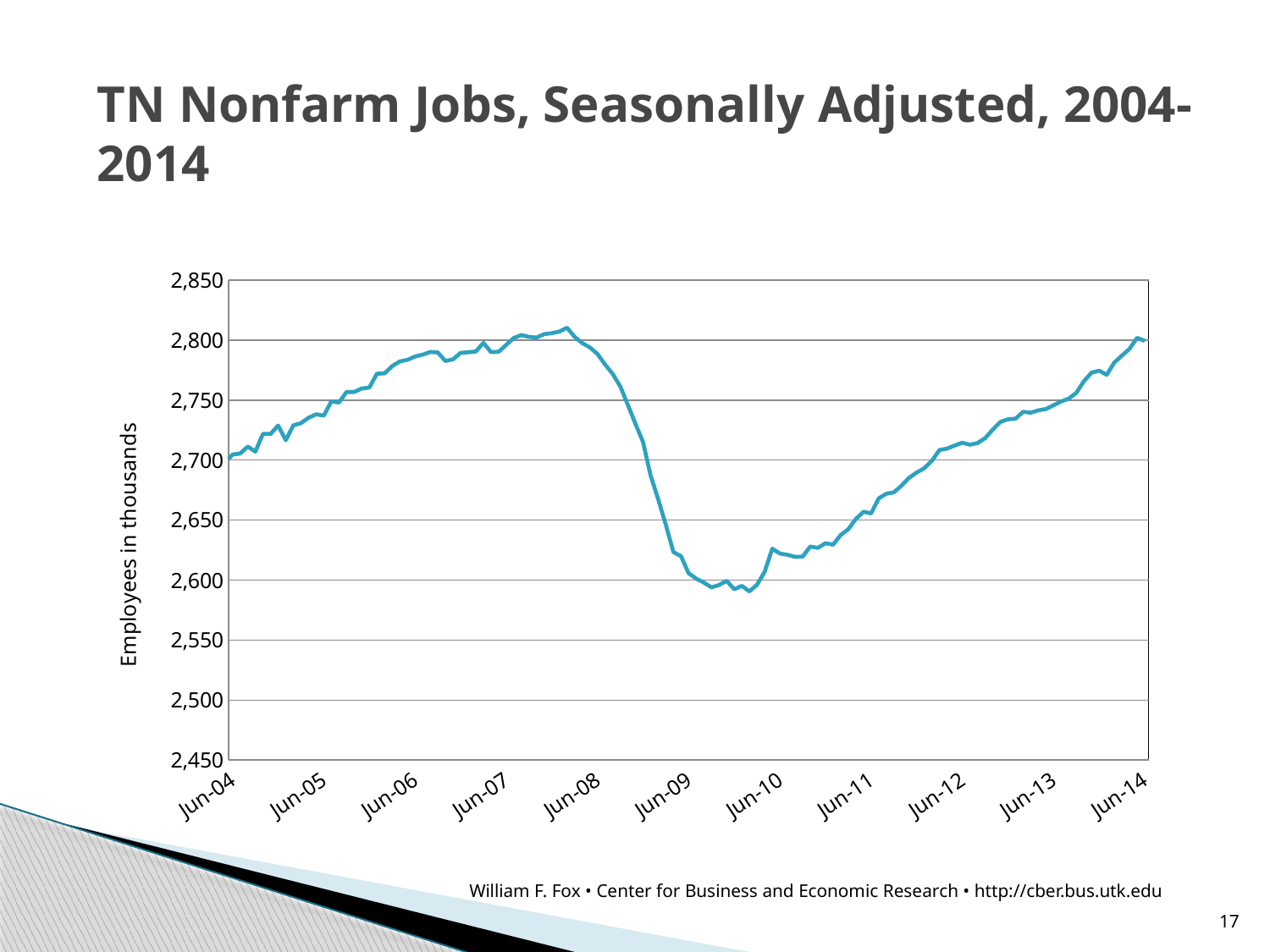
Is the value for Jun-06 greater or less than 2,750? greater Is the value for Jun-12 greater or less than 2,700? greater What is the title of the chart? TN Nonfarm Jobs, Seasonally Adjusted, 2004-2014 Is the value for Jun-09 greater or less than 2,650? less Does the line rise or fall between Jun-10 and Jun-14? rise Does the line rise or fall between Jun-08 and Jun-09? fall Which of Jun-08 and Jun-10 has the higher value? Jun-08 How many labelled tick marks are there on the horizontal axis? 11 What kind of chart is shown on the slide? line chart What is the label on the vertical axis of the chart? Employees in thousands